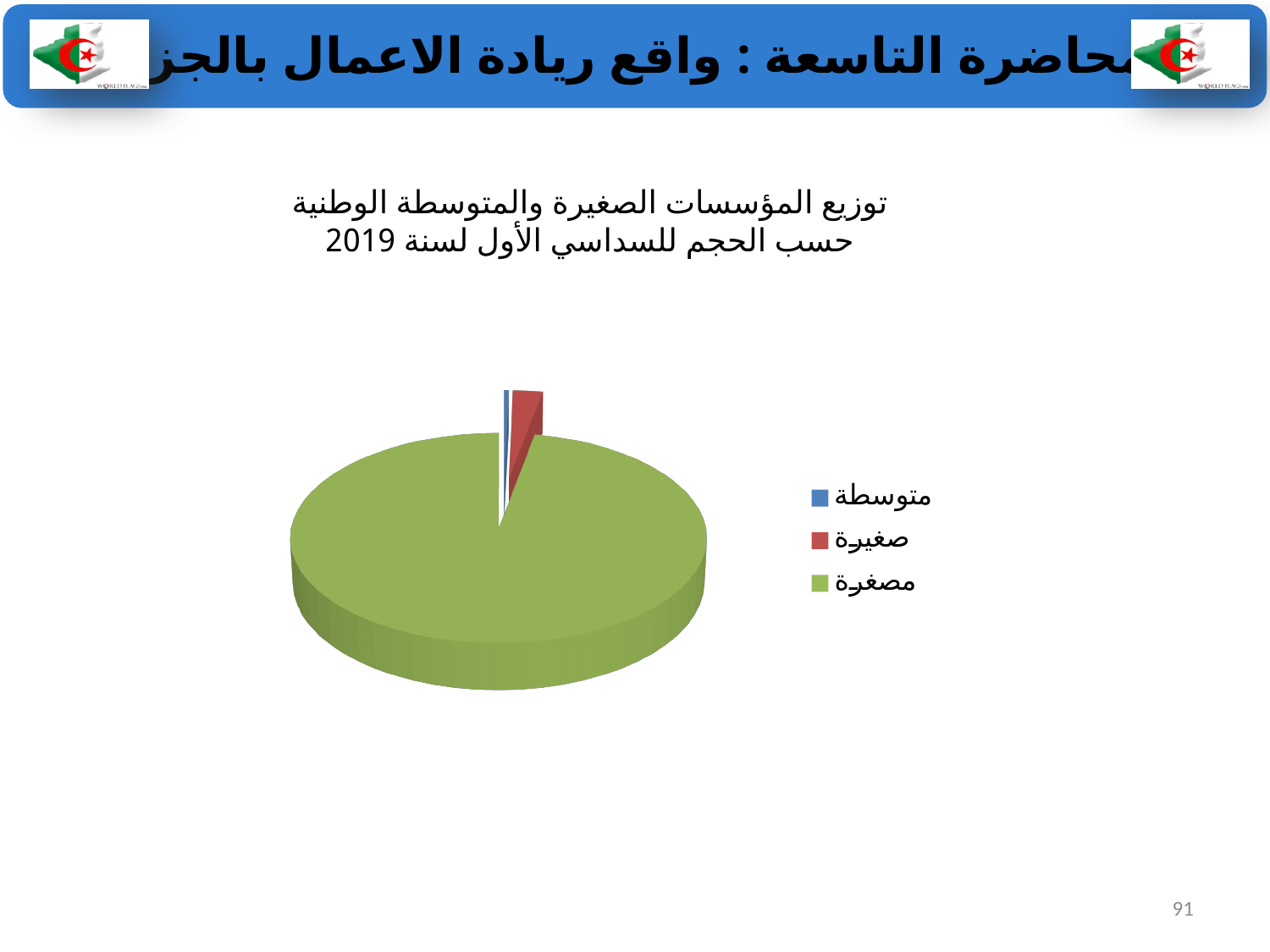
Which slice is larger in the pie chart, مصغرة or صغيرة? مصغرة What is the title of the pie chart? توزيع المؤسسات الصغيرة والمتوسطة الوطنية حسب الحجم للسداسي الأول لسنة 2019 How many entries does the legend of the pie chart list? 3 Which slice is larger in the pie chart, صغيرة or متوسطة? صغيرة What colour is the slice for مصغرة in the pie chart? Green Which category has the largest slice in the pie chart? مصغرة How many categories (slices) does the pie chart have? 3 Which category has the smallest slice in the pie chart? متوسطة What kind of chart is shown on the slide? Pie chart